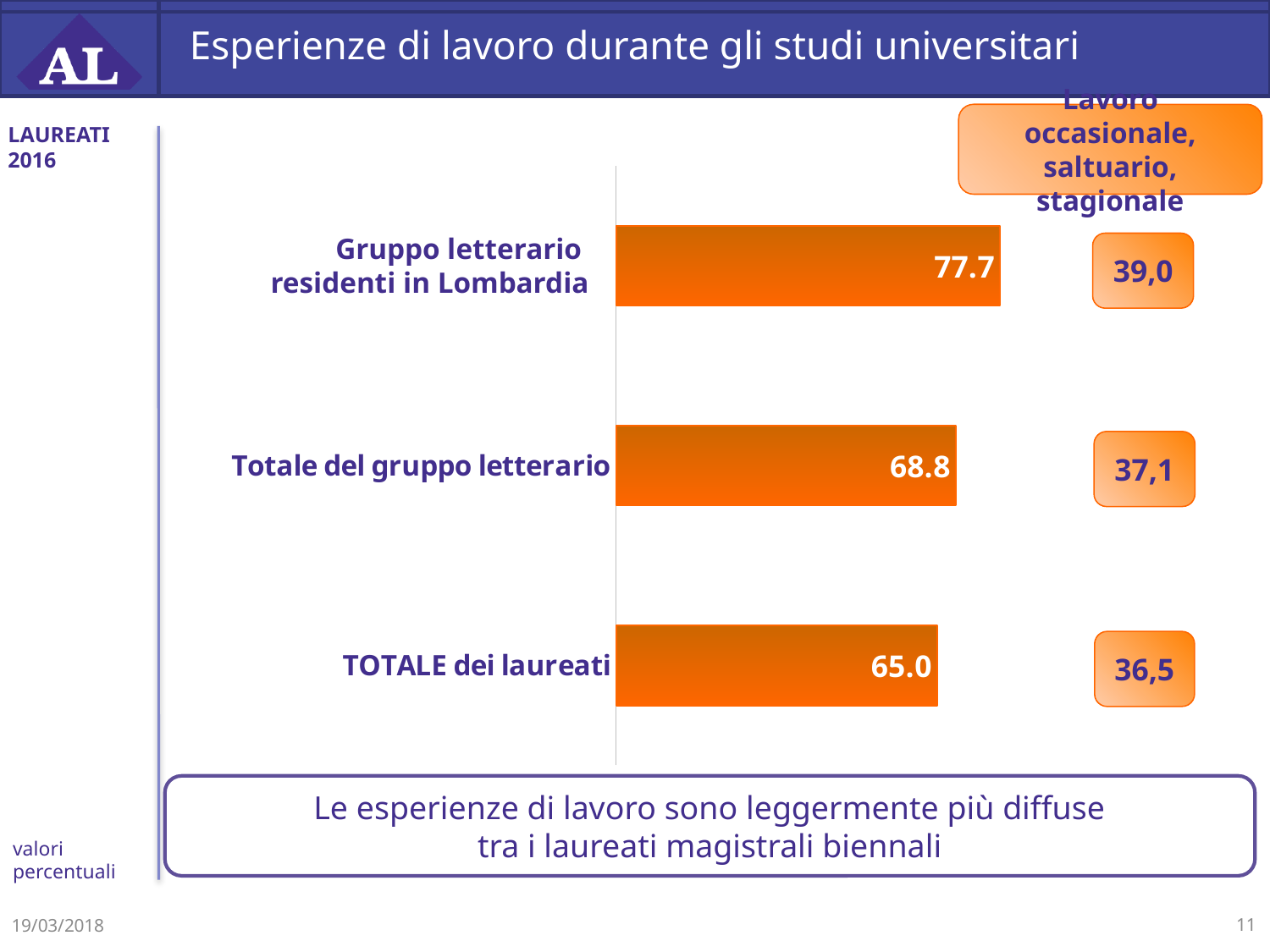
What is the difference between the values for Totale del gruppo letterario and TOTALE dei laureati? 3.8 How many categories are shown in the chart? 3 Which category has the lowest value? TOTALE dei laureati Which category has the highest value? Gruppo letterario residenti in Lombardia What is the difference between the values for Gruppo letterario residenti in Lombardia and TOTALE dei laureati? 12.7 What is the value for Totale del gruppo letterario? 68.8 What is the value for TOTALE dei laureati? 65.0 What kind of chart is shown on the slide? Bar chart What is the difference between the values for Gruppo letterario residenti in Lombardia and Totale del gruppo letterario? 8.9 Which is larger, the value for Totale del gruppo letterario or the value for TOTALE dei laureati? Totale del gruppo letterario What is the value for Gruppo letterario residenti in Lombardia? 77.7 What is the title of the slide containing the chart? Esperienze di lavoro durante gli studi universitari